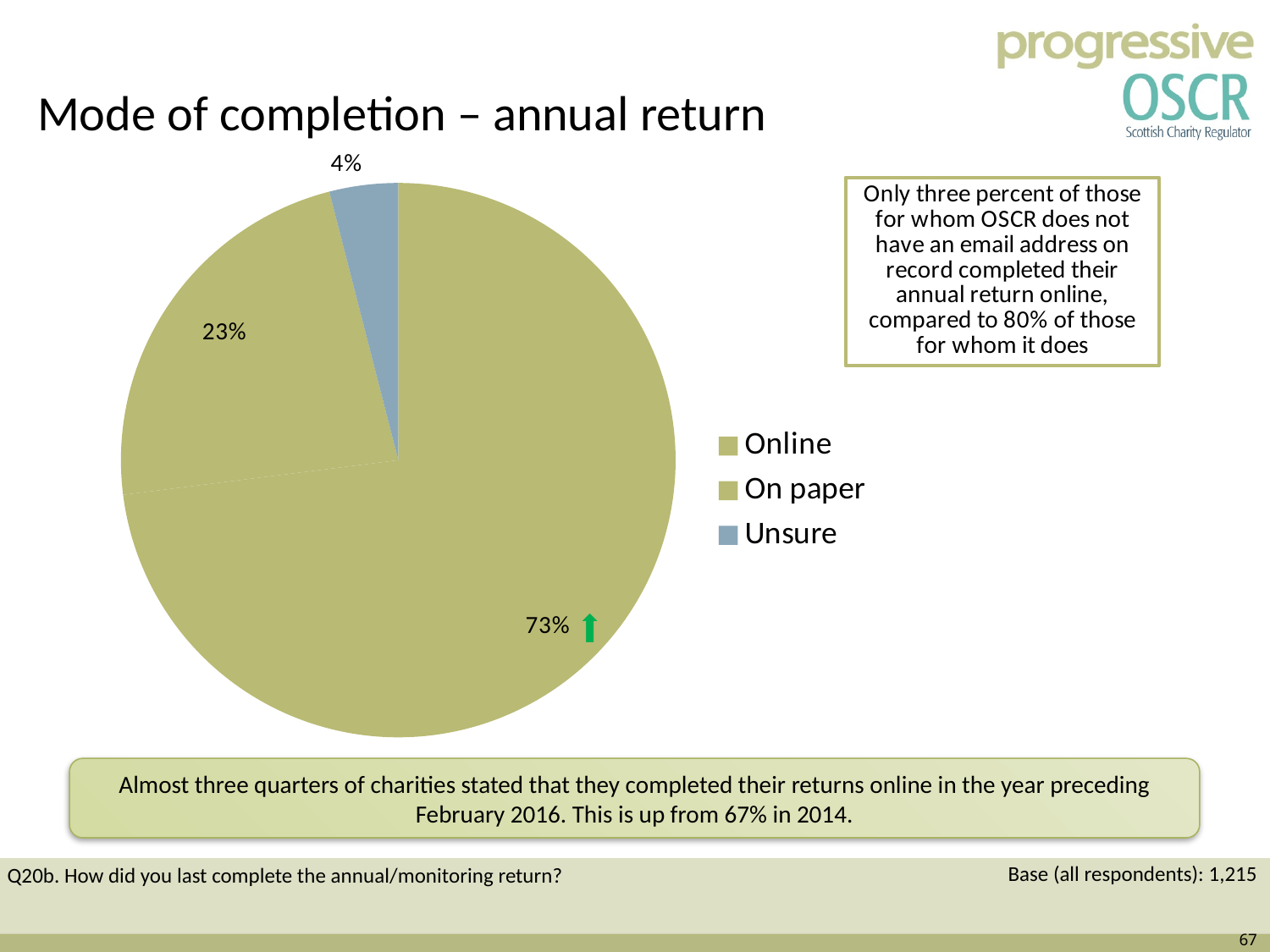
What is the base (number of respondents) for the chart? 1,215 What is the difference in percentage points between Online and On paper? 50 Which mode of completion has the smallest share of the pie? Unsure What kind of chart is shown on the slide? Pie chart What percentage of charities were unsure how they completed their annual return? 4% What percentage of charities completed their annual return on paper? 23% How many entries does the legend list? 3 Which mode of completion has the largest share of the pie? Online How many slices does the pie chart have? 3 What is the title of the slide containing the chart? Mode of completion – annual return What percentage of charities completed their annual return online? 73% Which is larger, the share for On paper or the share for Unsure? On paper